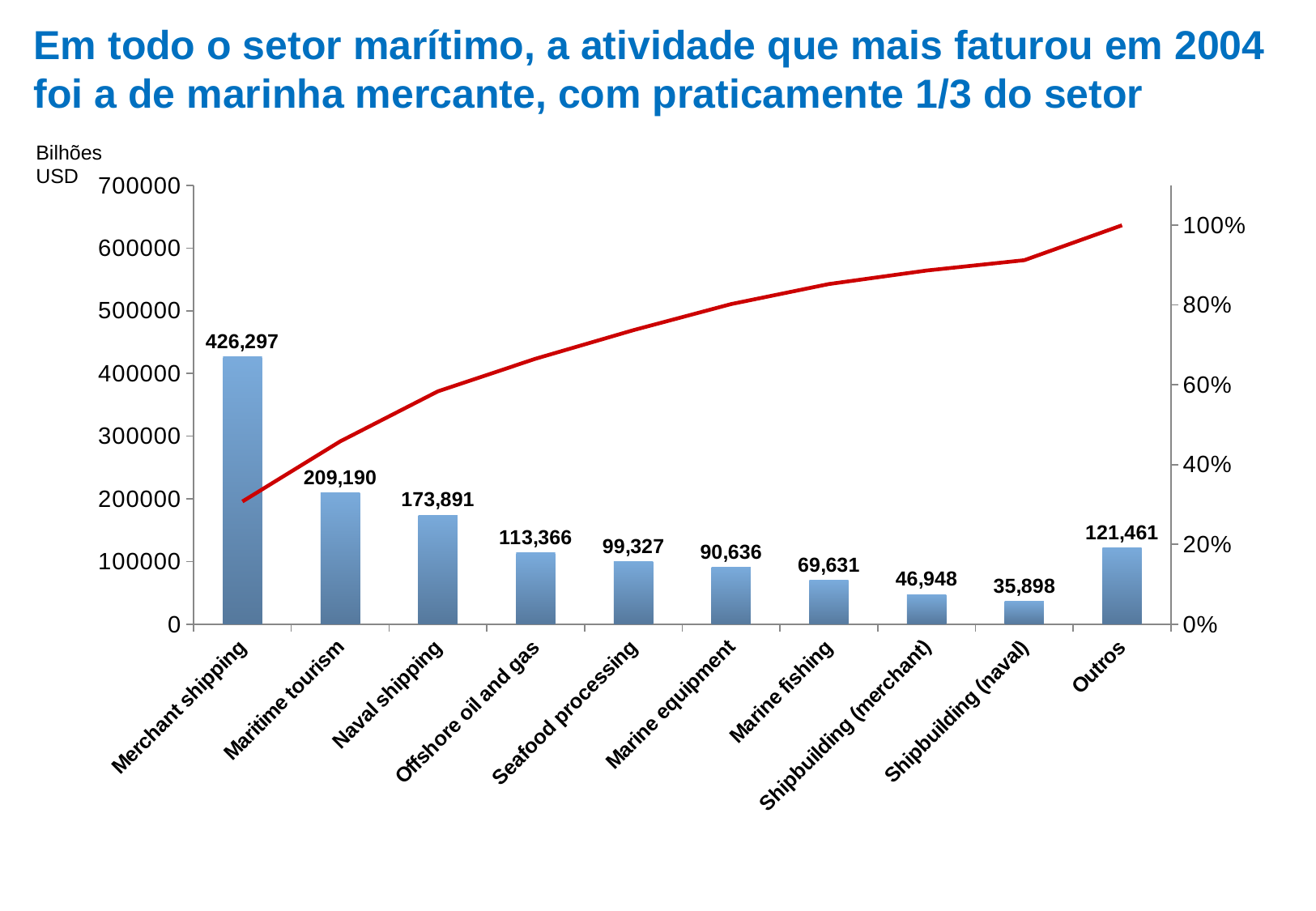
Which category has the highest bar? Merchant shipping How many categories are shown on the x axis? 10 What is the value for Outros? 121,461 Which category has the lowest bar? Shipbuilding (naval) What is the difference between the values for Merchant shipping and Maritime tourism? 217,107 Do the bar values rise or fall from Merchant shipping to Shipbuilding (naval)? fall What kind of chart is this? Bar chart with a line What is the value for Merchant shipping? 426,297 Is the cumulative percentage line at Merchant shipping greater or less than 40%? less What is the value for Shipbuilding (naval)? 35,898 Which is larger, the value for Outros or the value for Seafood processing? Outros What is the value for Offshore oil and gas? 113,366